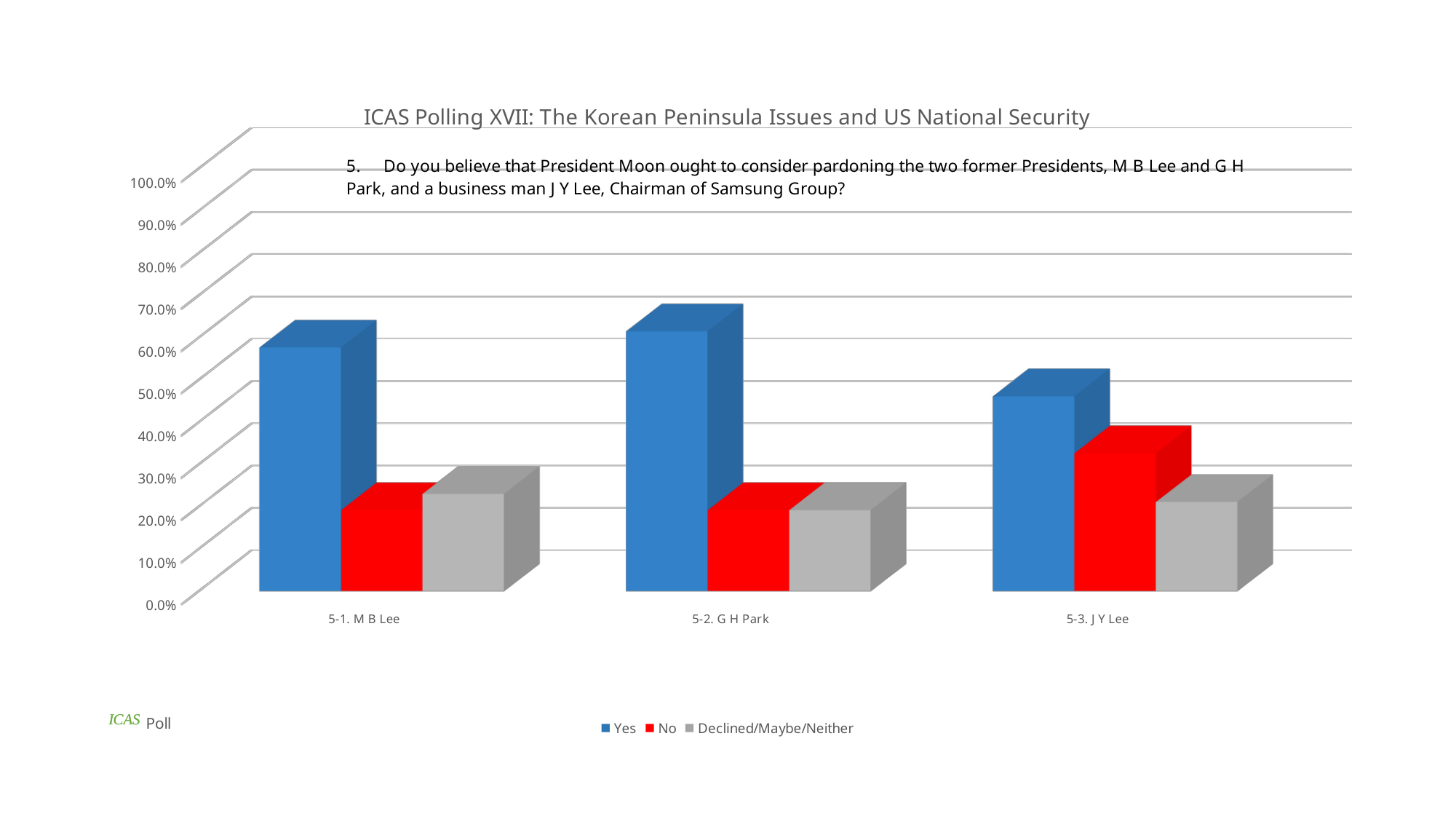
What kind of chart is shown on the slide? bar chart Is the Yes value for 5-3. J Y Lee greater or less than 70.0%? less Which category has the lowest Yes value? 5-3. J Y Lee How many series does the chart's legend list? 3 For 5-1. M B Lee, which is larger, the Yes value or the No value? Yes What are the three entries in the chart's legend? Yes, No, Declined/Maybe/Neither For 5-3. J Y Lee, which is larger, the No value or the Declined/Maybe/Neither value? No How many categories are shown on the x axis of the chart? 3 Which category has the highest Yes value? 5-2. G H Park Which category has the highest No value? 5-3. J Y Lee Is the No value for 5-3. J Y Lee greater or less than 20.0%? greater Is the Yes value for 5-2. G H Park greater or less than 50.0%? greater